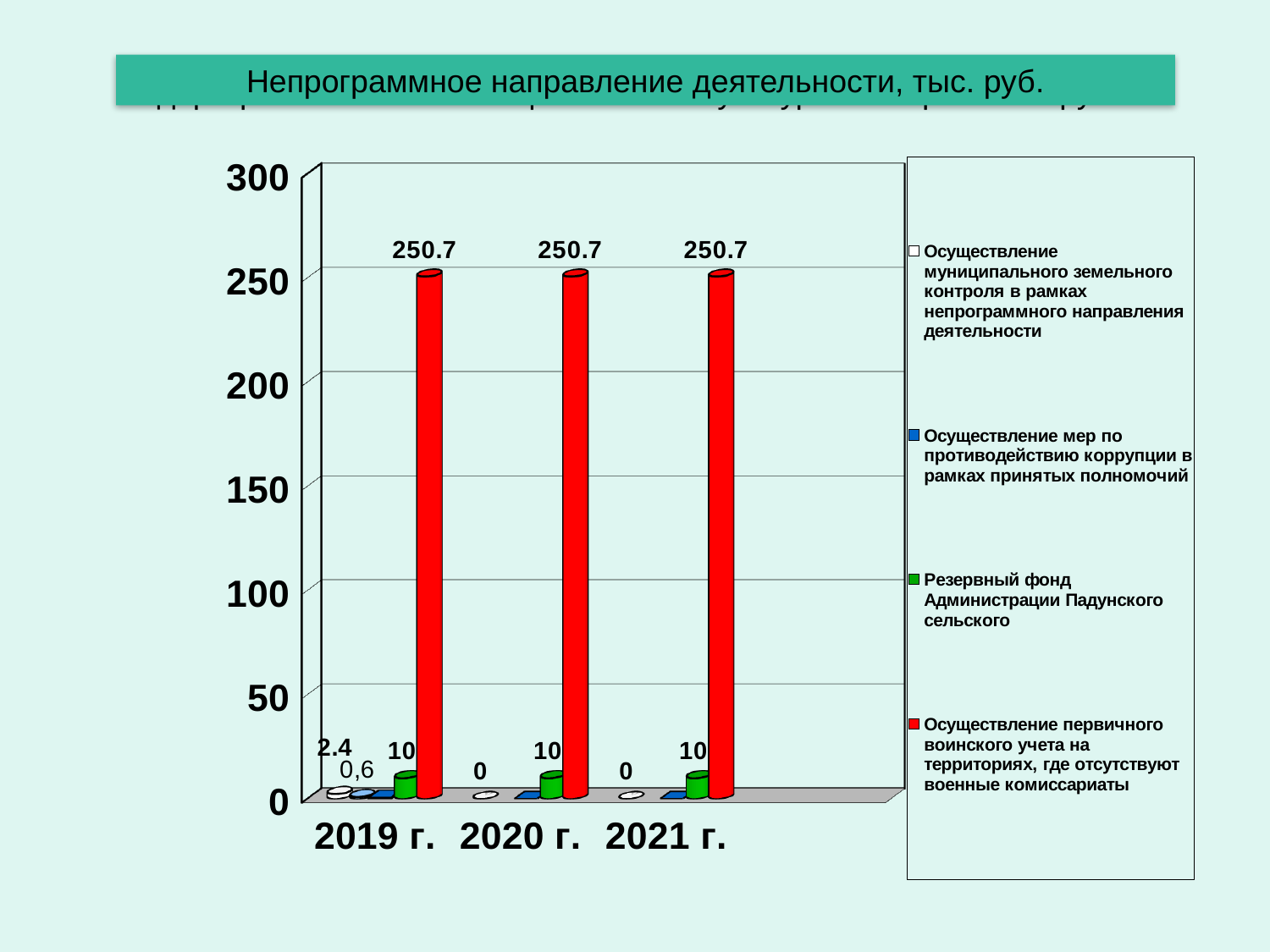
What is the title of the chart? Непрограммное направление деятельности, тыс. руб. Does the value for 'Осуществление первичного воинского учета' rise, fall or stay the same from 2019 г. to 2021 г.? stays the same What is the value for 'Резервный фонд Администрации Падунского сельского' in 2021 г.? 10 Is the value for 'Осуществление первичного воинского учета' in 2020 г. greater or less than 200? greater What kind of chart is shown on the slide? bar chart How many series does the legend list? 4 How many year categories are shown on the x axis? 3 What is the value for 'Осуществление муниципального земельного контроля в рамках непрограммного направления деятельности' in 2020 г.? 0 What is the difference between the value for 'Осуществление первичного воинского учета' and 'Резервный фонд Администрации Падунского сельского' in 2021 г.? 240.7 What is the value for 'Осуществление первичного воинского учета на территориях, где отсутствуют военные комиссариаты' in 2019 г.? 250.7 Which is larger in 2019 г.: the value for 'Резервный фонд Администрации Падунского сельского' or the value for 'Осуществление первичного воинского учета'? Осуществление первичного воинского учета Which series has the highest value in 2020 г.? Осуществление первичного воинского учета на территориях, где отсутствуют военные комиссариаты